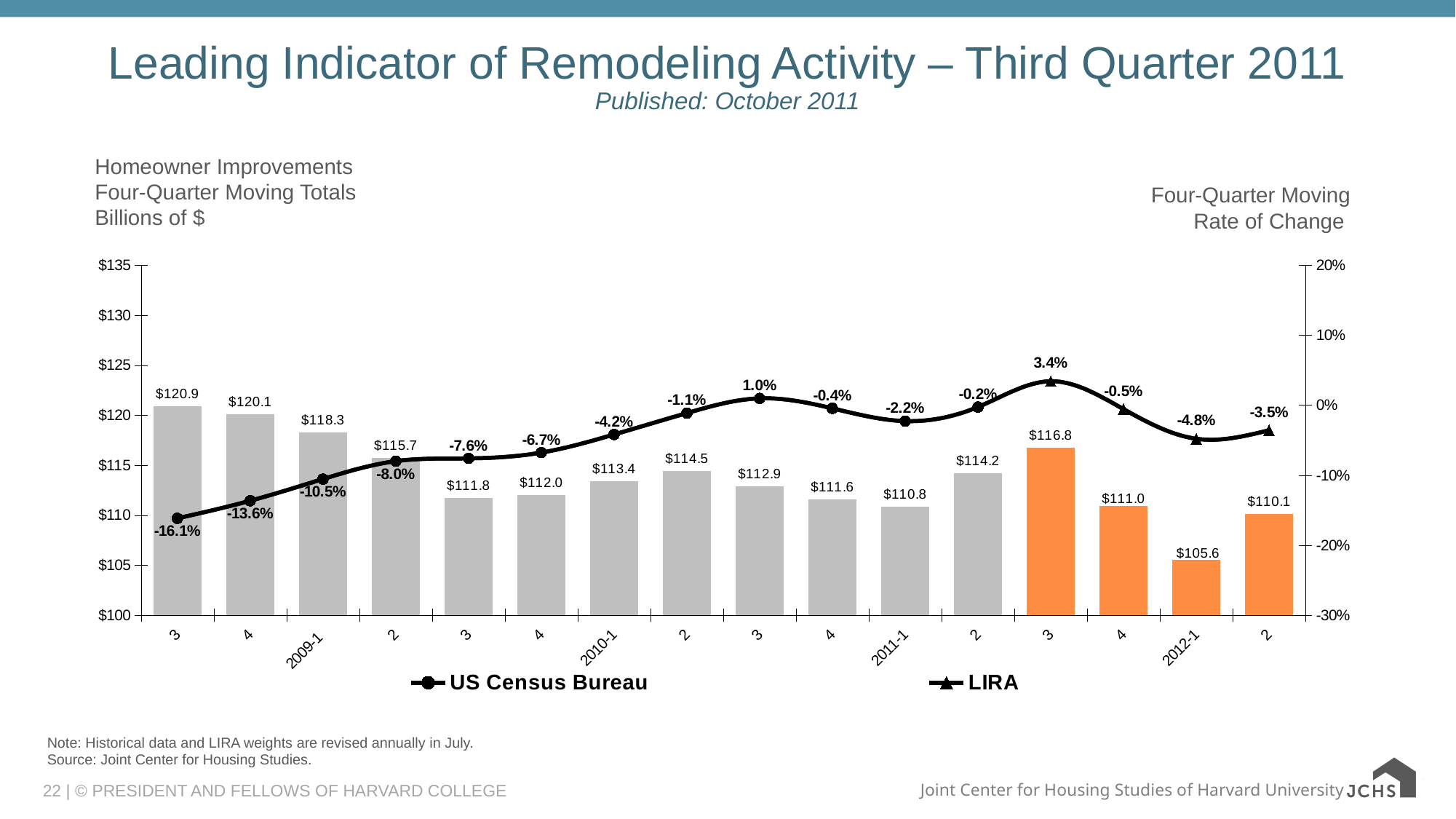
What rate of change is labeled on the line at 2010-1? -4.2% What are the two series named in the legend? US Census Bureau and LIRA What is the four-quarter moving total for the last bar on the chart (labeled 2, after 2012-1)? $110.1 How many series does the legend list? 2 Which quarter has the lowest four-quarter moving total bar? 2012-1 How many bars are plotted in the chart? 16 Which is larger, the four-quarter moving total for 2010-1 or for 2011-1? 2010-1 What is the highest rate of change labeled on the line? 3.4% What rate of change is labeled on the line at 2011-1? -2.2% What is the difference between the four-quarter moving totals for 2009-1 and 2010-1? $4.9 What is the four-quarter moving total shown for 2009-1? $118.3 What is the four-quarter moving total shown for 2012-1? $105.6